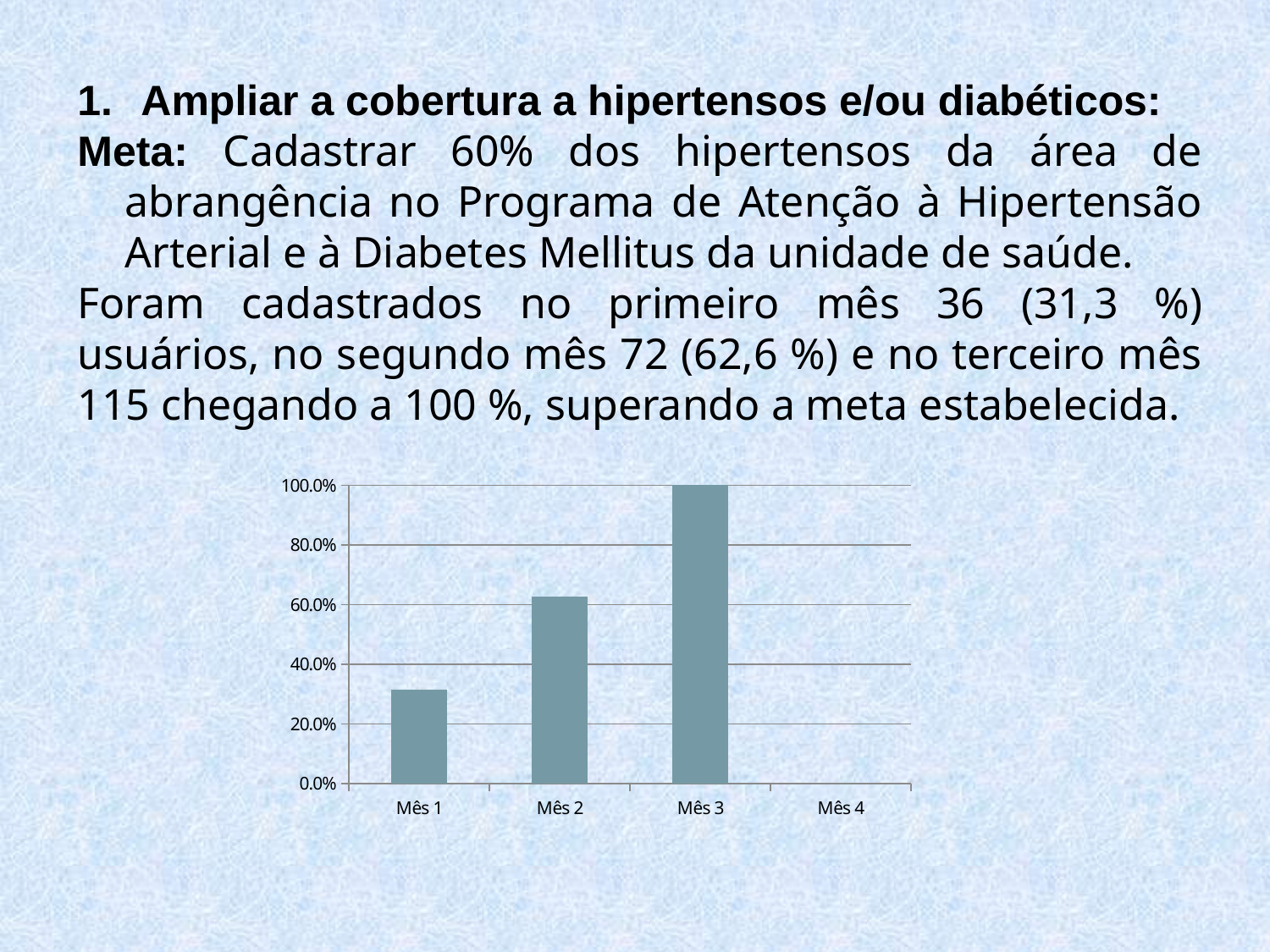
Do the bar values rise or fall from Mês 1 to Mês 3? rise What kind of chart is shown on the slide? bar chart Is the value for Mês 1 greater or less than 40.0%? less Is the value for Mês 1 greater or less than 20.0%? greater Is the value for Mês 2 greater or less than 80.0%? less Which category has the highest bar in the chart? Mês 3 Which bar is taller, Mês 1 or Mês 2? Mês 2 What is the value of the bar for Mês 3? 100.0% How many categories are shown on the x axis of the chart? 4 Among the three categories with a visible bar, which has the lowest bar? Mês 1 Which category on the x axis has no visible bar? Mês 4